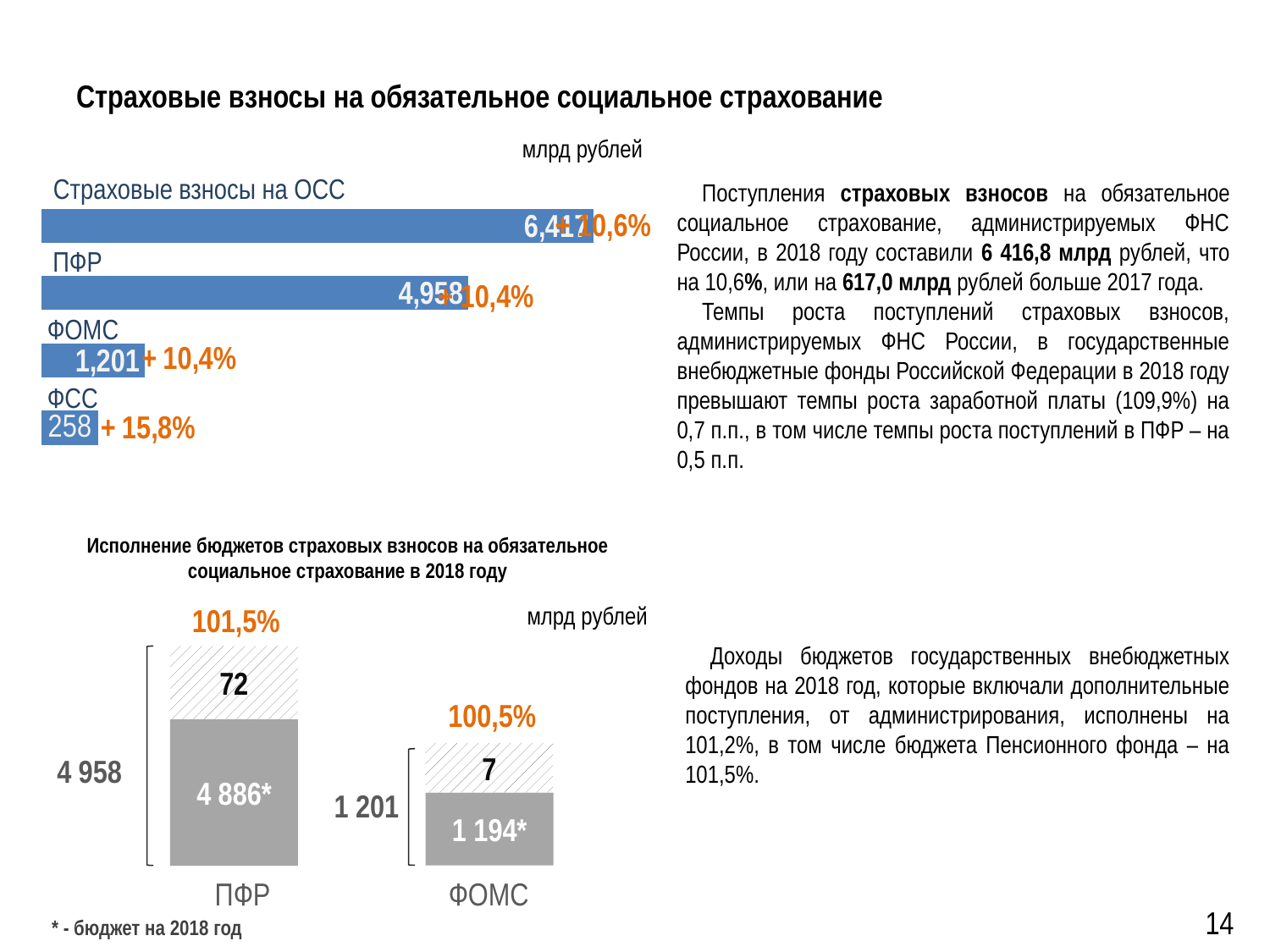
In the top chart (Страховые взносы на ОСС), what is the value for ФОМС? 1,201 In the bottom chart (Исполнение бюджетов страховых взносов), what is the total for ФОМС? 1 201 In the top chart (Страховые взносы на ОСС), what is the difference between the ФОМС value and the ФСС value? 943 In the top chart (Страховые взносы на ОСС), what is the value for ФСС? 258 In the top chart (Страховые взносы на ОСС), what growth rate is shown next to the ФСС bar? + 15,8% In the top chart (Страховые взносы на ОСС), what growth rate is shown next to the ФОМС bar? + 10,4% What type of chart is the top chart (Страховые взносы на ОСС)? Bar chart In the top chart (Страховые взносы на ОСС), which fund shows the highest growth rate? ФСС In the bottom chart (Исполнение бюджетов страховых взносов), what execution percentage is shown above the ПФР bar? 101,5% In the bottom chart (Исполнение бюджетов страховых взносов), what is the total for ПФР? 4 958 In the top chart (Страховые взносы на ОСС), how many bars are shown? 4 In the bottom chart (Исполнение бюджетов страховых взносов), what is the value of the hatched top segment for ФОМС? 7